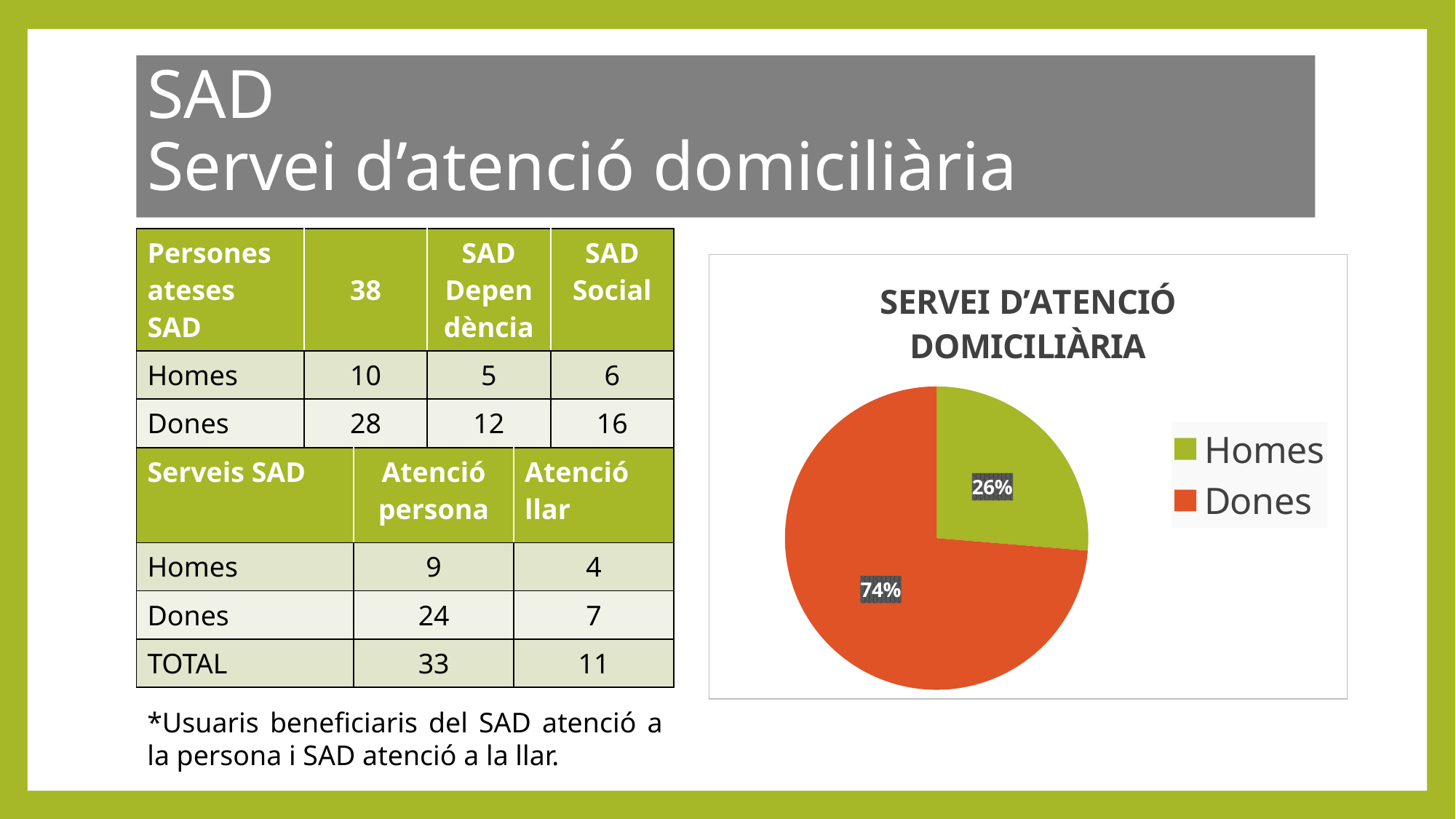
What kind of chart is shown on the slide? pie chart What share of the pie does Dones represent? 74% What is the difference in percentage points between the Dones and Homes slices? 48 Which category has the smallest slice of the pie? Homes What share of the pie does Homes represent? 26% How many entries does the legend list? 2 Which slice is larger, Homes or Dones? Dones What is the title of the chart? SERVEI D'ATENCIÓ DOMICILIÀRIA How many categories does the pie chart show? 2 What colour is the Dones slice? orange-red Which category has the largest slice of the pie? Dones